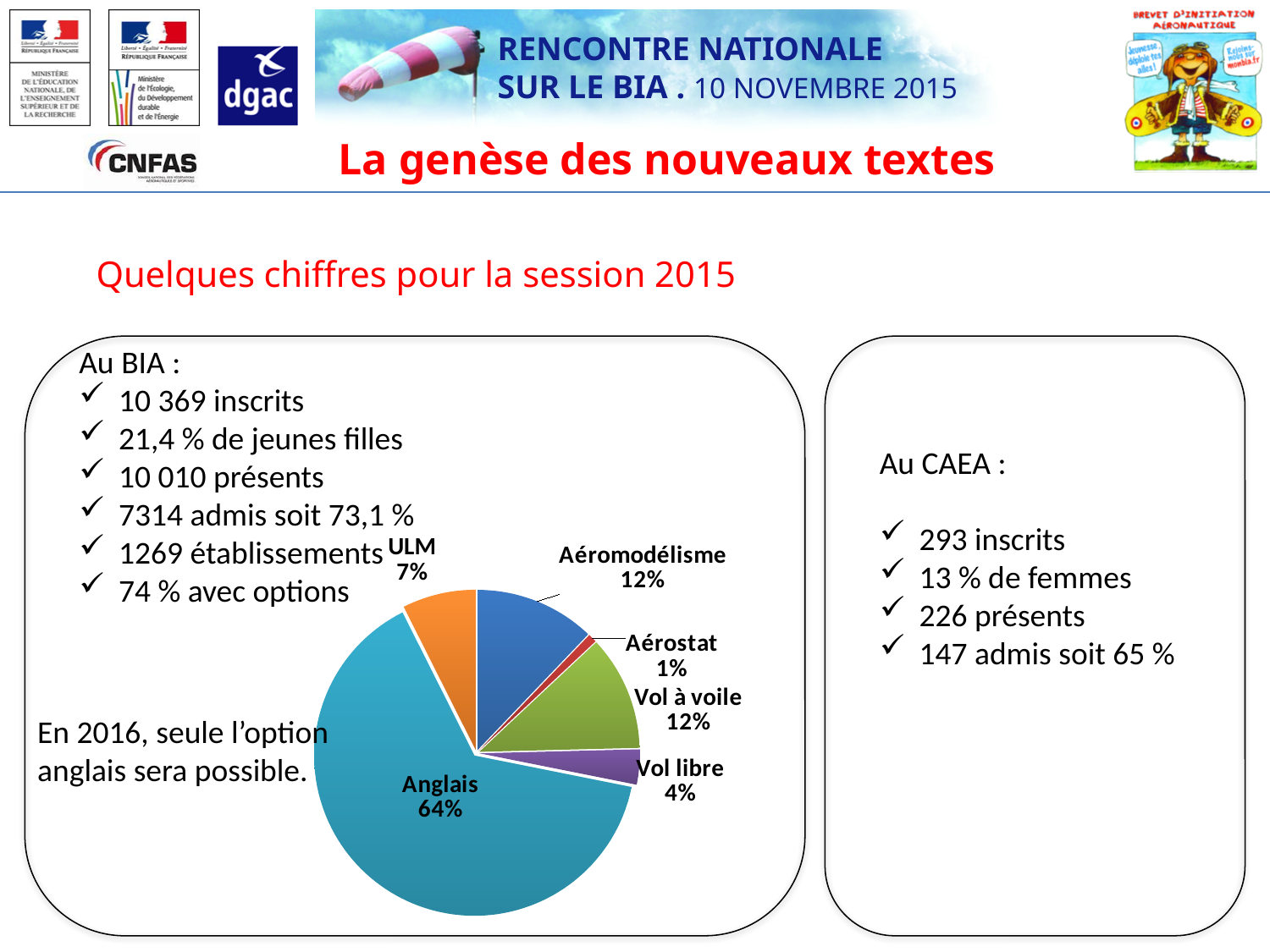
What is the value shown for ULM in the pie chart? 7% What is the value shown for Vol libre in the pie chart? 4% What is the difference between the Anglais share and the ULM share? 57% Which slice of the pie chart is the smallest? Aérostat What share of the pie does Anglais represent? 64% Do Aéromodélisme and Vol à voile have the same share in the pie chart? Yes, both 12% Which is larger in the pie chart, Vol libre or ULM? ULM How many slices does the pie chart have? 6 What is the value shown for Aérostat in the pie chart? 1% Which slice of the pie chart is the largest? Anglais What colour is the Anglais slice of the pie chart? teal (blue-green) What kind of chart is shown on the slide? pie chart